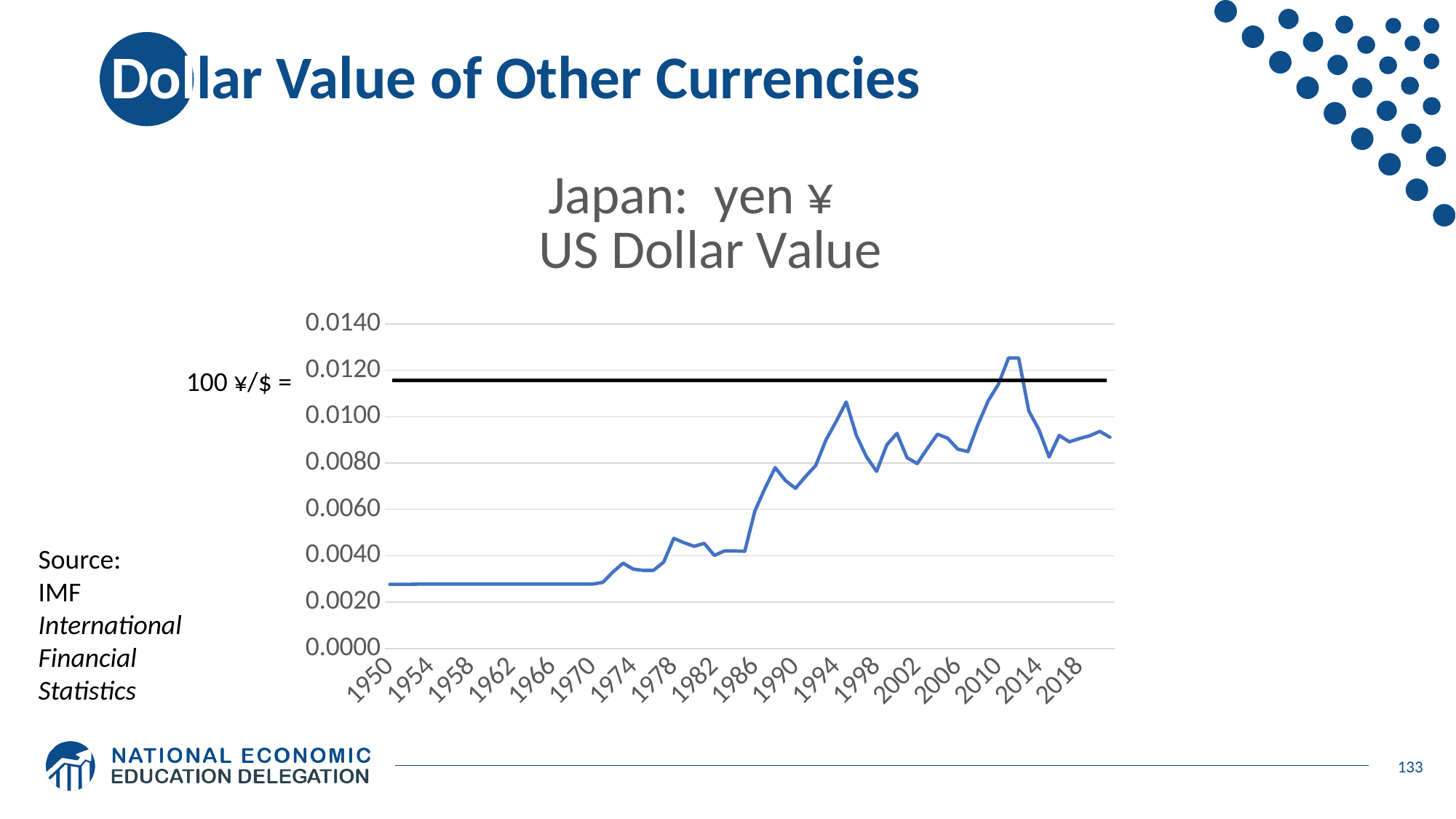
Is the value for 1970 greater or less than 0.0040? less Overall, does the US dollar value of the yen rise or fall from 1950 to 2018? rise Is the value for 2018 greater or less than 0.0080? greater What kind of chart is shown on the slide? line chart Is the peak value reached in the early 2010s greater or less than 0.0120? greater What is the title of the chart? Japan: yen ¥ US Dollar Value How many year labels are shown on the x axis? 18 What label is attached to the horizontal black reference line on the chart? 100 ¥/$ = In which decade does the line reach its highest value? 2010s Which is larger, the value for 1950 or the value for 2018? 2018